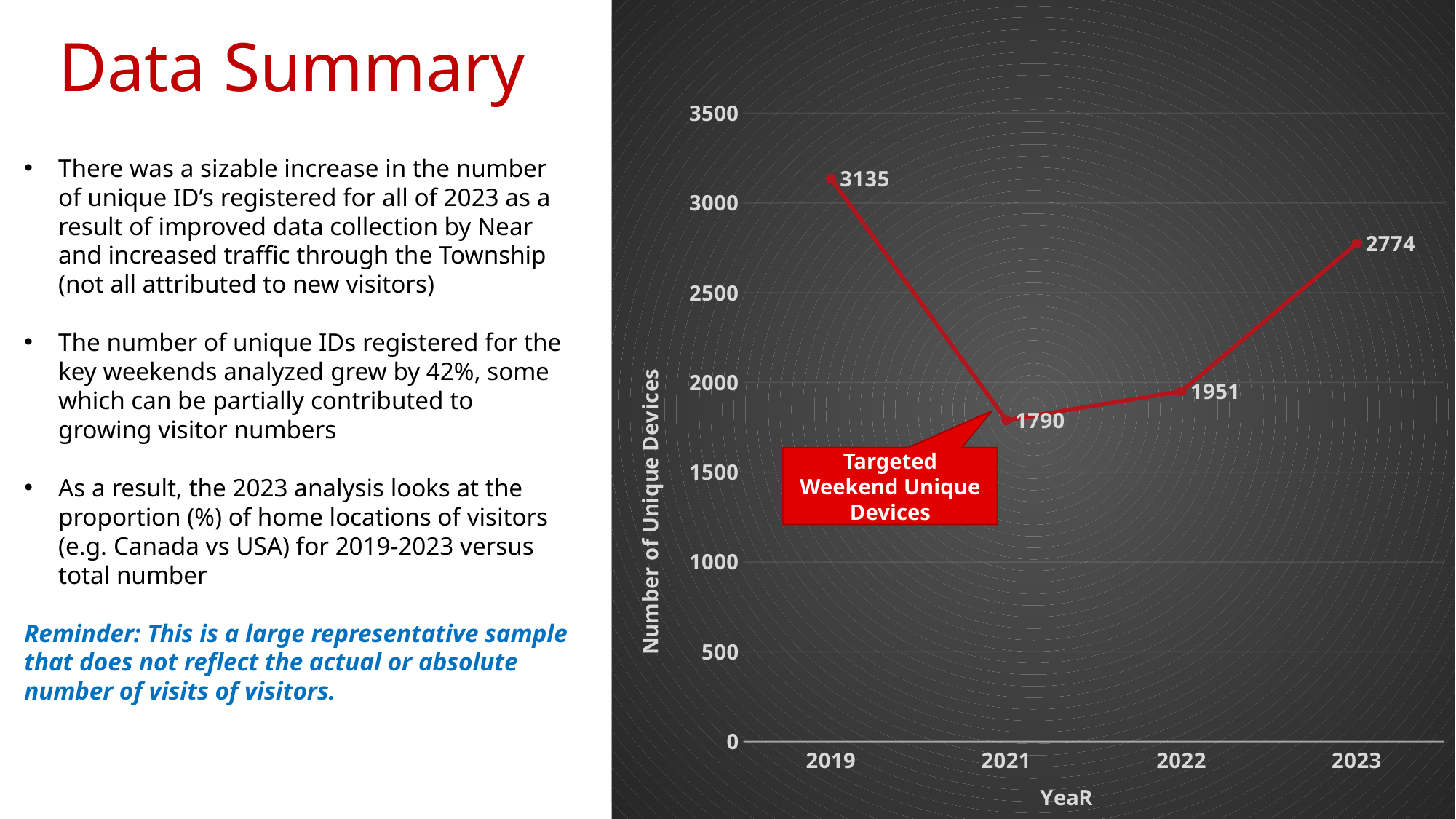
What is the label of the y axis of the chart? Number of Unique Devices Which year has more unique devices, 2022 or 2023? 2023 What is the number of unique devices for 2023? 2774 Which year has the lowest number of unique devices? 2021 What is the difference in unique devices between 2019 and 2021? 1345 Which year has the highest number of unique devices? 2019 What kind of chart is shown on the slide? line chart What is the difference in unique devices between 2023 and 2022? 823 What is the number of unique devices for 2021? 1790 What is the number of unique devices for 2022? 1951 What is the number of unique devices for 2019? 3135 How many years are plotted on the chart? 4